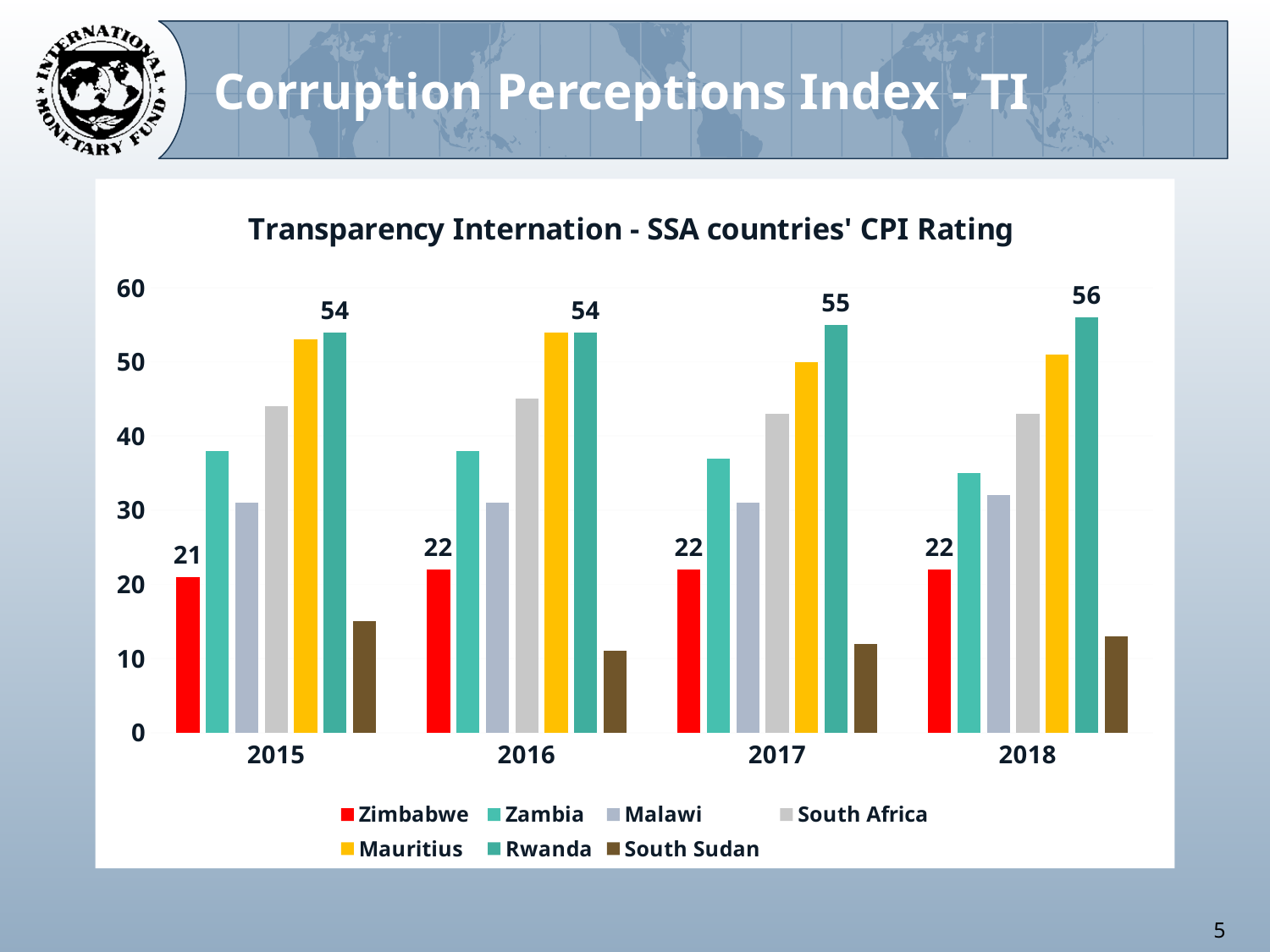
Is the value for Mauritius in 2017 greater or less than 40? greater Which country has the lowest CPI rating in 2017? South Sudan Is the value for South Sudan in 2016 greater or less than 20? less What is the CPI rating for Rwanda in 2017? 55 What is the CPI rating for Rwanda in 2018? 56 By how much did Rwanda's CPI rating change from 2015 to 2018? 2 What is the difference between Rwanda's and Zimbabwe's CPI ratings in 2016? 32 What type of chart is shown on the slide? Bar chart How many countries are listed in the legend? 7 Which country has the highest CPI rating in 2018? Rwanda What is the CPI rating for Zimbabwe in 2015? 21 What is the CPI rating for Zimbabwe in 2018? 22